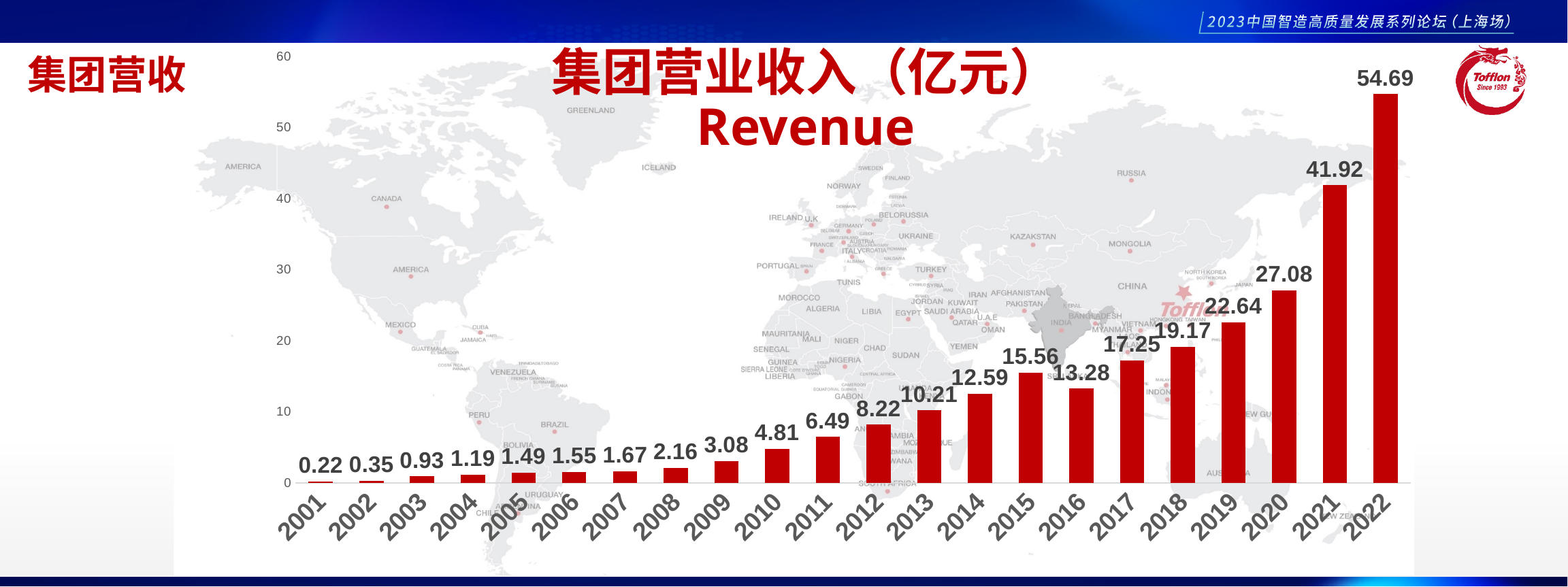
What is the revenue value shown for 2015? 15.56 What is the revenue value shown for 2001? 0.22 How many years are shown on the x axis of the chart? 22 What is the revenue value shown for 2022? 54.69 Which year has the lowest revenue? 2001 Is the revenue for 2020 greater or less than 30? less What unit is given in the chart title for the revenue values? 亿元 Which year has the larger revenue, 2015 or 2016? 2015 Does the revenue generally rise or fall from 2001 to 2022? rise What kind of chart is used to show the revenue? bar chart Which year has the highest revenue? 2022 What is the difference between the revenue in 2022 and in 2021? 12.77